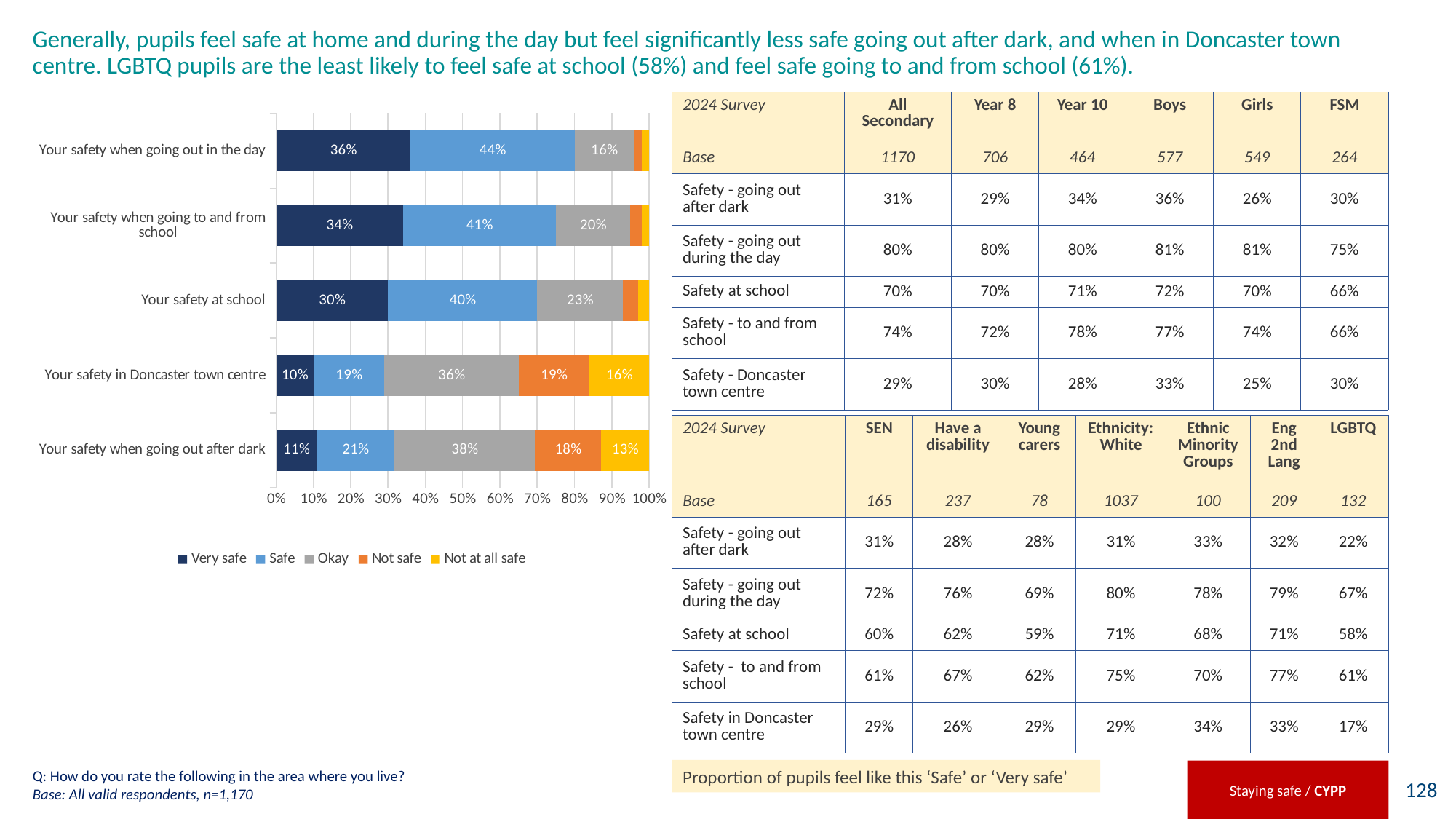
What is the difference between the 'Safe' percentage for 'Your safety when going out in the day' and for 'Your safety when going out after dark'? 23 percentage points What percentage of pupils said 'Very safe' for 'Your safety when going out in the day'? 36% What colour represents 'Not at all safe' in the chart? Yellow Which category has the lowest 'Very safe' percentage? Your safety in Doncaster town centre Which has a larger 'Okay' percentage: 'Your safety when going out after dark' or 'Your safety in Doncaster town centre'? Your safety when going out after dark Which category has the highest 'Very safe' percentage? Your safety when going out in the day What percentage of pupils said 'Not at all safe' for 'Your safety when going out after dark'? 13% How many series does the chart legend list? 5 What is the combined 'Very safe' and 'Safe' percentage for 'Your safety when going to and from school'? 75% What percentage of pupils said 'Okay' for 'Your safety in Doncaster town centre'? 36% What type of chart is shown on the slide? Stacked bar chart How many categories are shown in the bar chart? 5